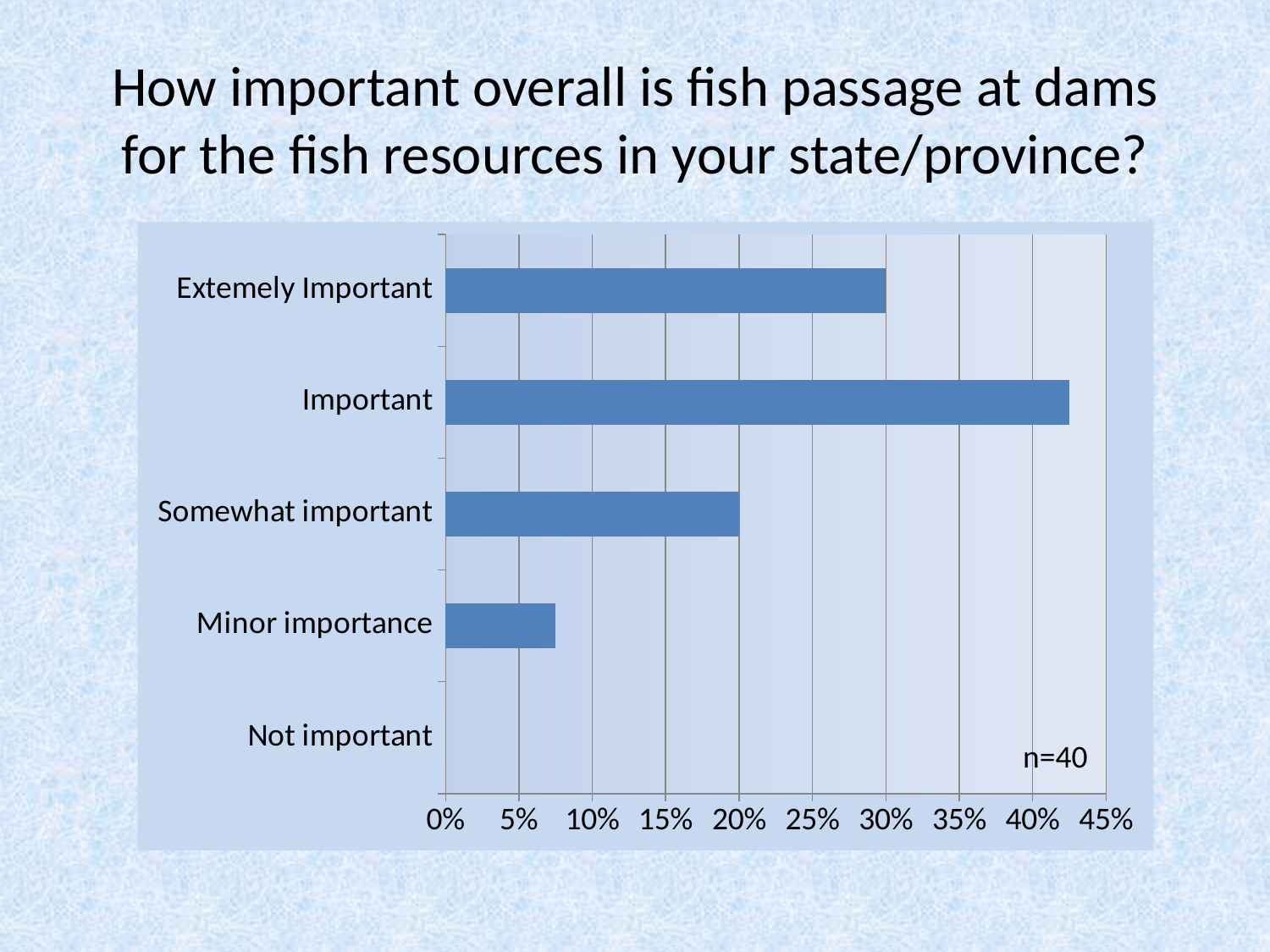
Which category has the highest value? Important What is the value for Extemely Important? 30% Which category has the lowest value? Not important Is the value for Extemely Important greater or less than 35%? less How many categories are shown on the chart? 5 Which is larger, the value for Minor importance or the value for Somewhat important? Somewhat important Is the value for Important greater or less than 40%? greater What sample size (n) is noted on the chart? n=40 Is the value for Minor importance greater or less than 10%? less What is the value for Somewhat important? 20% What kind of chart is shown on the slide? bar chart Which is larger, the value for Extemely Important or the value for Somewhat important? Extemely Important